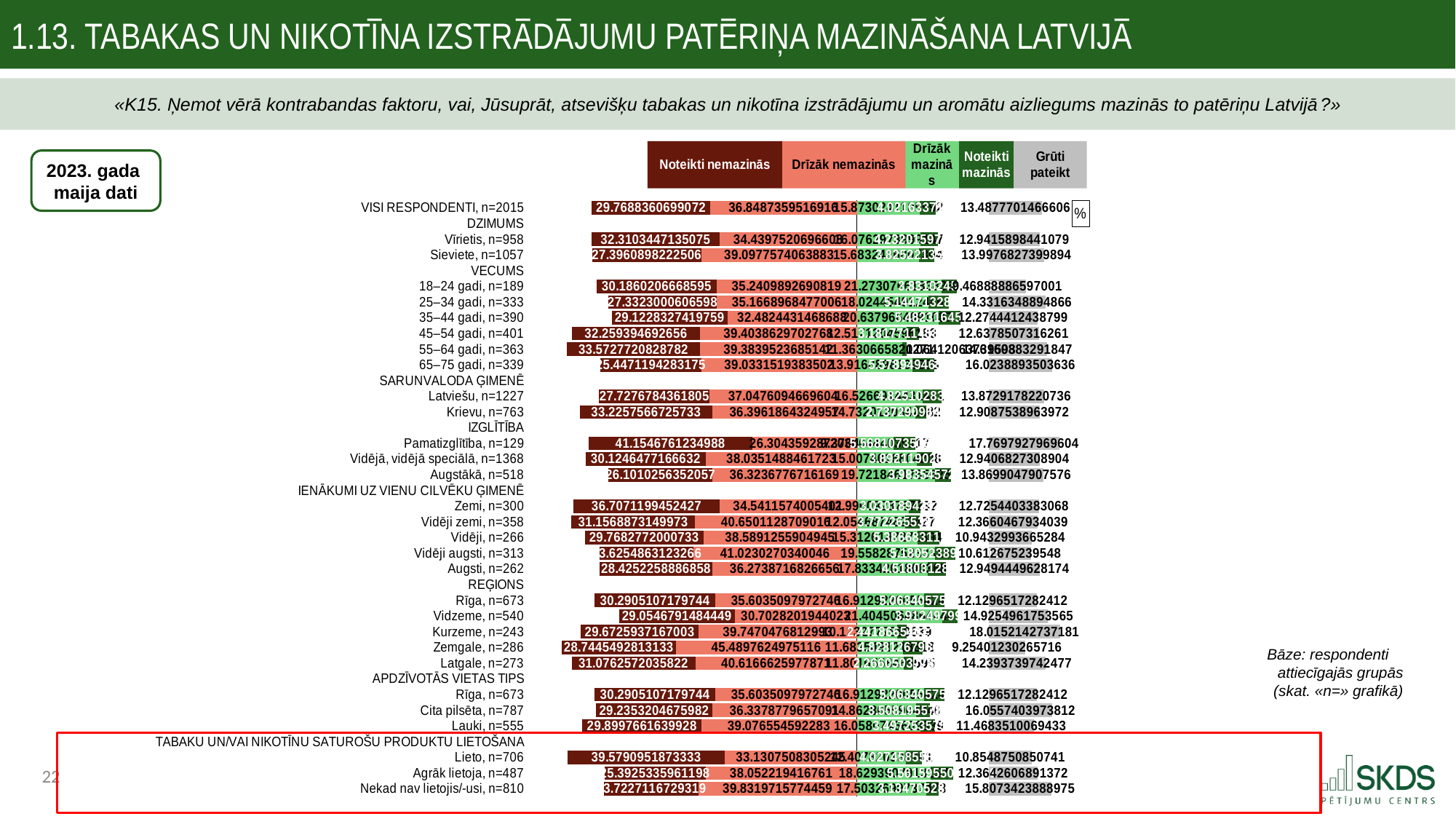
Which has the larger 'Noteikti nemazinās' value, Vīrietis, n=958 or Sieviete, n=1057? Vīrietis, n=958 What is the 'Drīzāk nemazinās' value for Zemgale, n=286? 45.4897624975116 What is the 'Noteikti nemazinās' value for VISI RESPONDENTI, n=2015? 29.7688360699072 What is the 'Noteikti nemazinās' value for Lieto, n=706? 39.5790951873333 Which group has the highest 'Noteikti nemazinās' value? Pamatizglītība, n=129 What is the 'Noteikti nemazinās' value for Pamatizglītība, n=129? 41.1546761234988 What is the 'Grūti pateikt' value for Zemgale, n=286? 9.25401230265716 Which group has the lowest 'Grūti pateikt' value? Zemgale, n=286 What is the 'Grūti pateikt' value for VISI RESPONDENTI, n=2015? 13.4877701466606 What colour represents the 'Noteikti nemazinās' series in the legend? Dark red How many series does the legend list? 5 What kind of chart is shown on the slide? Stacked bar chart